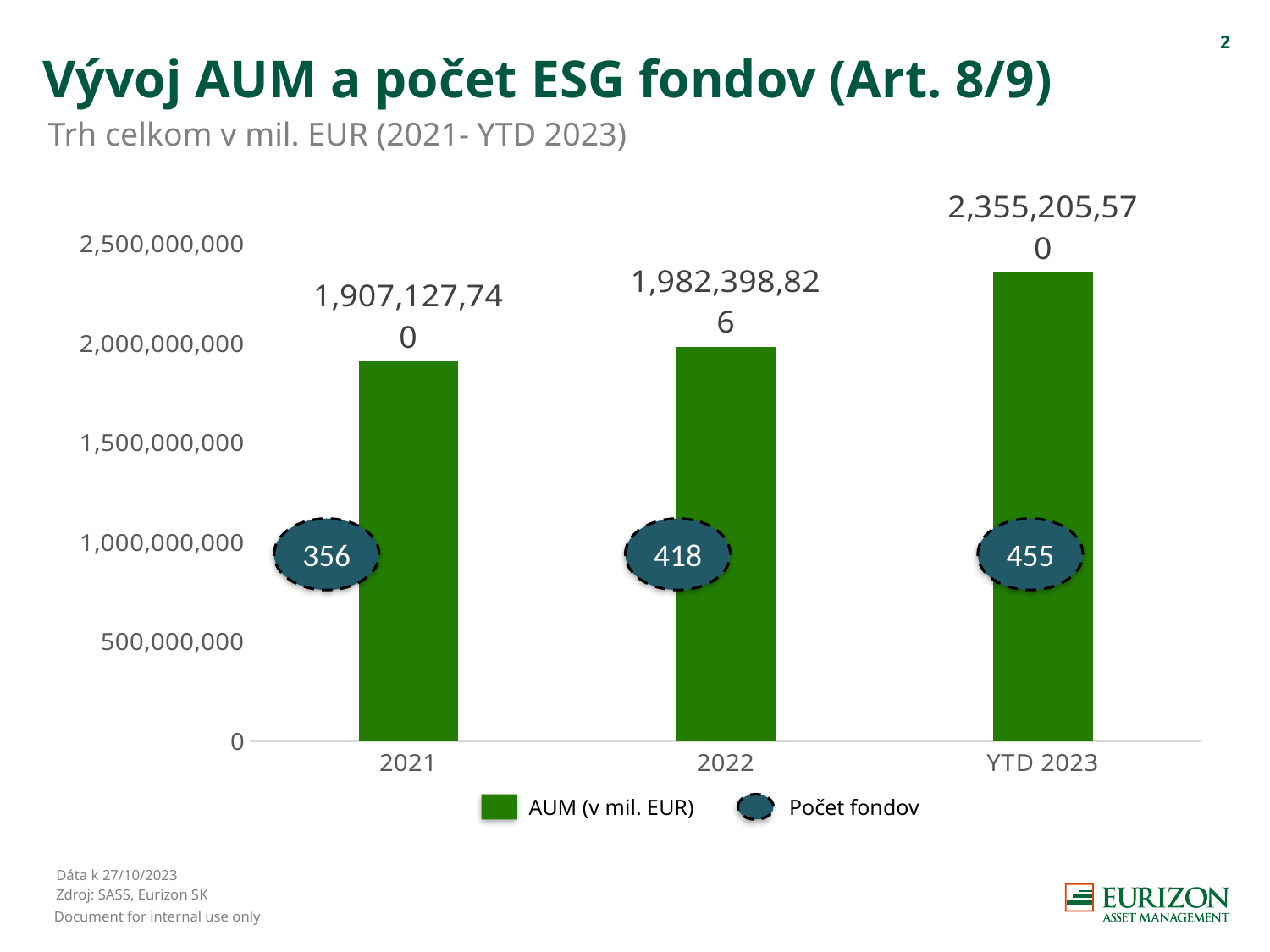
How many categories are shown on the x axis? 3 What is the difference in AUM between YTD 2023 and 2022? 372,806,744 What is the AUM value shown for 2021? 1,907,127,740 Which year has the lowest number of funds (Počet fondov)? 2021 By how much did the number of funds increase from 2021 to YTD 2023? 99 How many series does the legend list? 2 How many ESG funds (Počet fondov) are shown for 2022? 418 Which year has the highest AUM? YTD 2023 Is the AUM for 2022 larger or smaller than the AUM for 2021? larger What is the AUM value shown for YTD 2023? 2,355,205,570 Does AUM rise or fall from 2021 to YTD 2023? rise Is the AUM bar for 2021 greater or less than 2,000,000,000? less